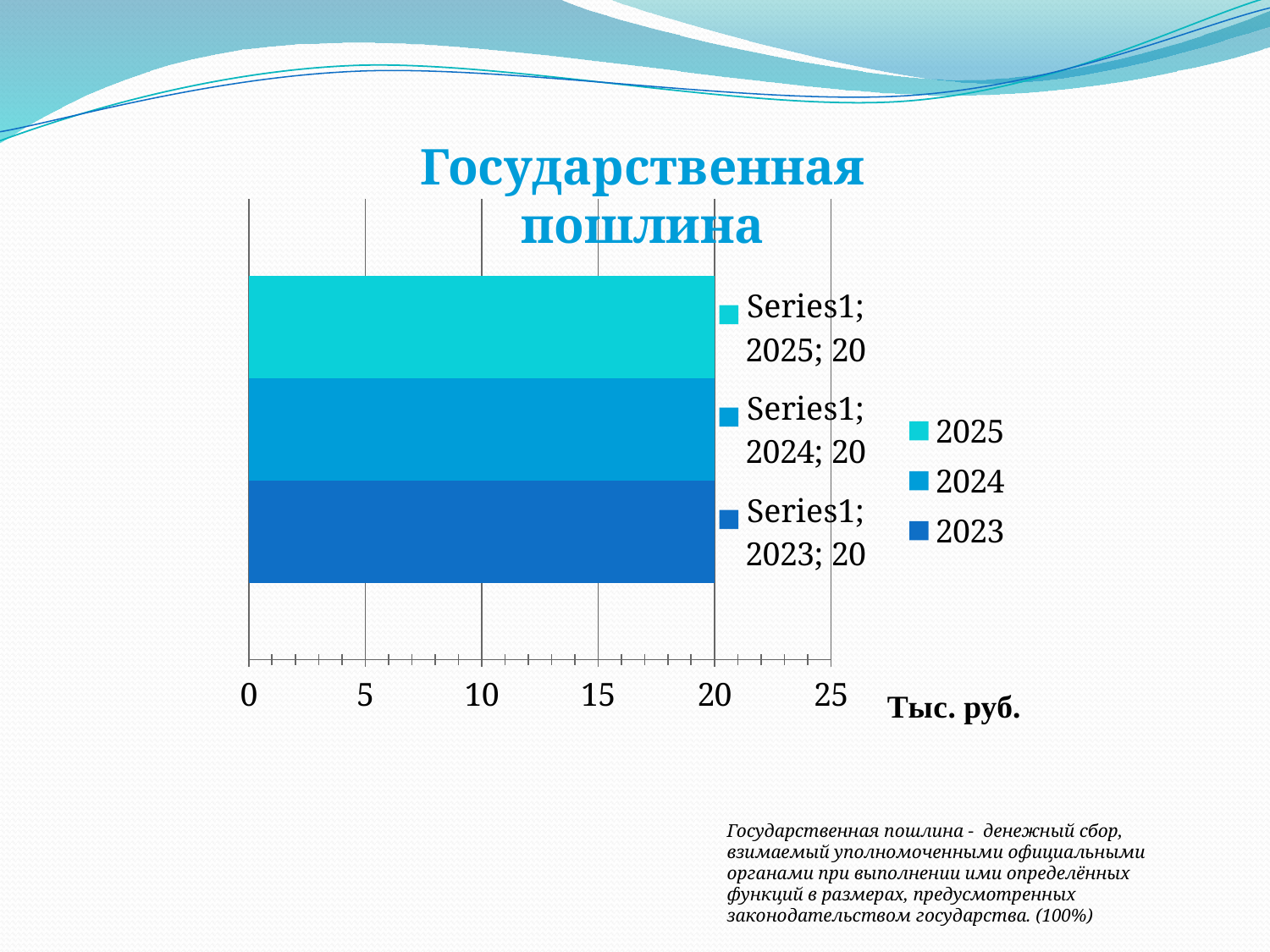
What unit is shown next to the horizontal axis? Тыс. руб. What is the value for 2025 in the chart? 20 What is the title of the chart? Государственная пошлина Is the value for 2023 greater or less than 25? less What kind of chart is shown on the slide? bar chart What is the difference between the values for 2025 and 2023? 0 How many entries does the legend list? 3 Do the values change from 2023 to 2025? No, they stay the same at 20 How many bars are plotted in the chart? 3 What is the value for 2024 in the chart? 20 What is the value for 2023 in the chart? 20 Is the value for 2024 greater or less than 15? greater